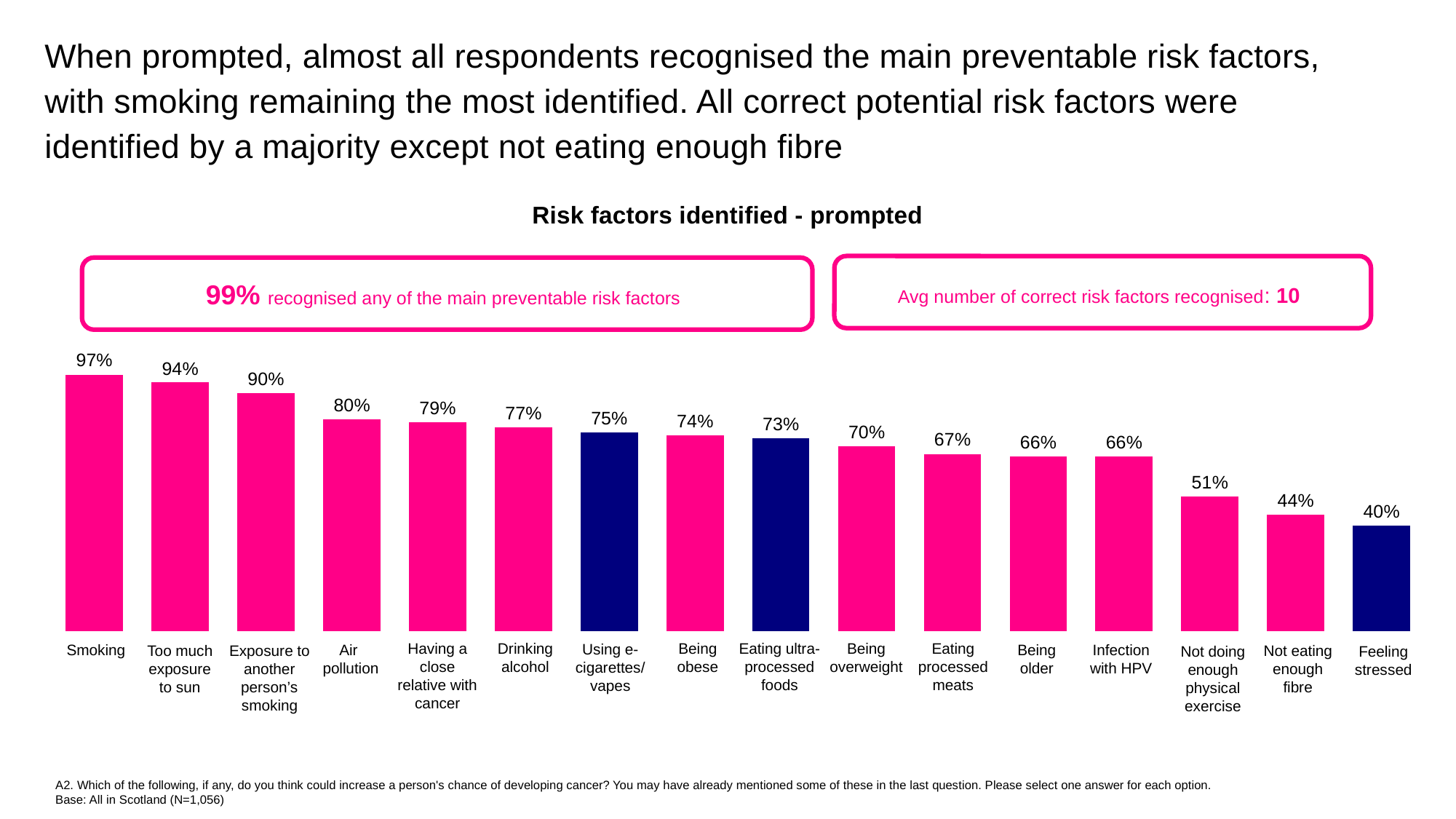
What is the difference between the values for 'Smoking' and 'Feeling stressed'? 57% What kind of chart is shown on the slide? Bar chart Which risk factor has the highest value? Smoking What percentage of respondents identified smoking as a risk factor? 97% What is the title of the chart? Risk factors identified - prompted Which is larger, the value for 'Too much exposure to sun' or 'Exposure to another person's smoking'? Too much exposure to sun Which risk factor has the lowest value? Feeling stressed What is the value for 'Not eating enough fibre'? 44% How many risk factor categories are shown in the chart? 16 What is the value for 'Using e-cigarettes/vapes'? 75% Do the values rise or fall from left to right across the chart? Fall What is the difference between the values for 'Air pollution' and 'Being obese'? 6%